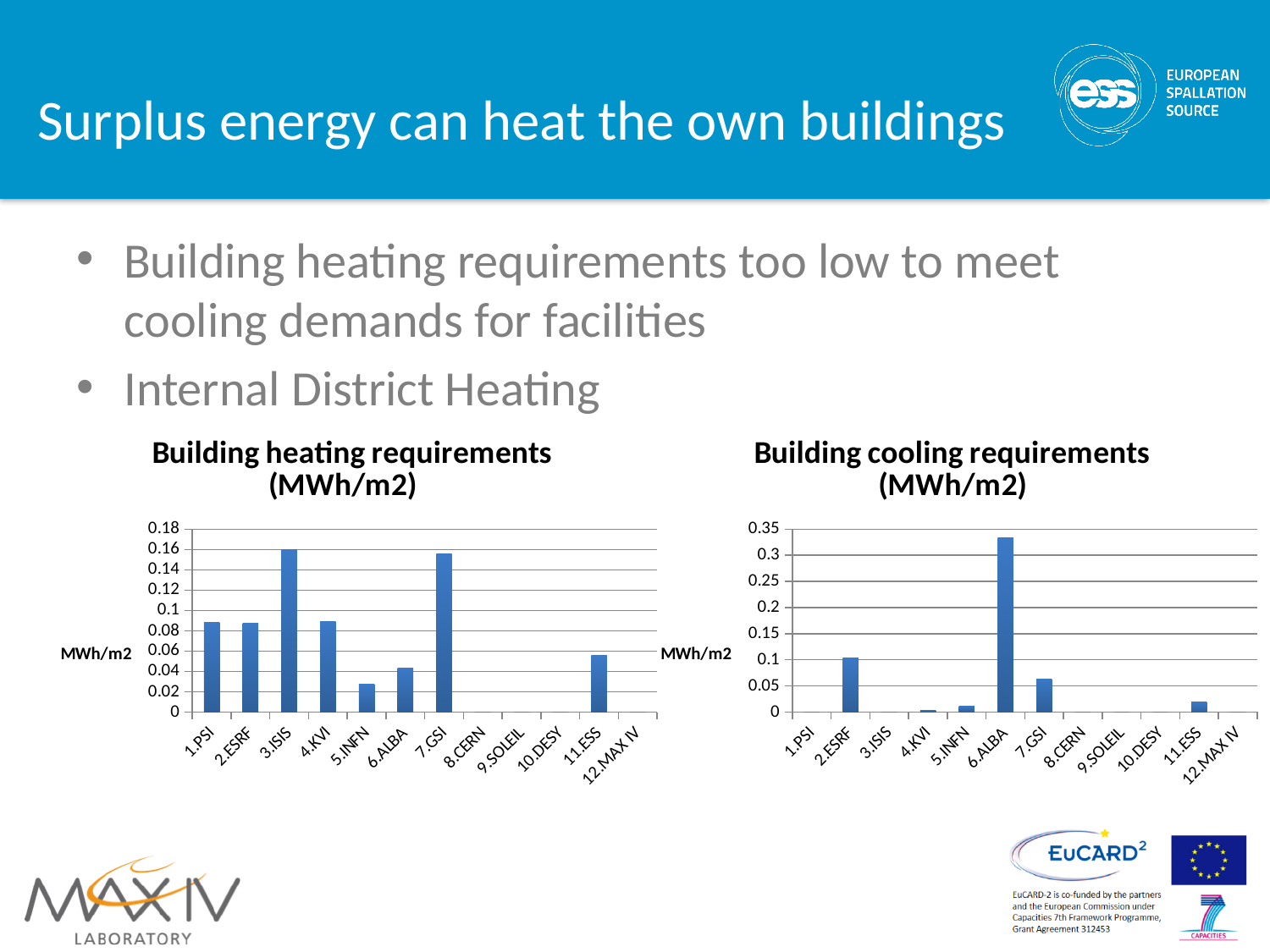
What kind of chart is the 'Building heating requirements (MWh/m2)' chart? bar chart In the 'Building cooling requirements (MWh/m2)' chart, which is larger, the value for 2.ESRF or the value for 7.GSI? 2.ESRF In the 'Building heating requirements (MWh/m2)' chart, is the value for 5.INFN greater or less than 0.04? less In the 'Building heating requirements (MWh/m2)' chart, is the value for 3.ISIS greater or less than 0.14? greater In the 'Building heating requirements (MWh/m2)' chart, is the value for 11.ESS greater or less than 0.04? greater What is the y-axis label on the 'Building heating requirements (MWh/m2)' chart? MWh/m2 How many categories are shown on the x axis of the 'Building cooling requirements (MWh/m2)' chart? 12 In the 'Building cooling requirements (MWh/m2)' chart, which category has the highest value? 6.ALBA In the 'Building heating requirements (MWh/m2)' chart, which is larger, the value for 3.ISIS or the value for 5.INFN? 3.ISIS